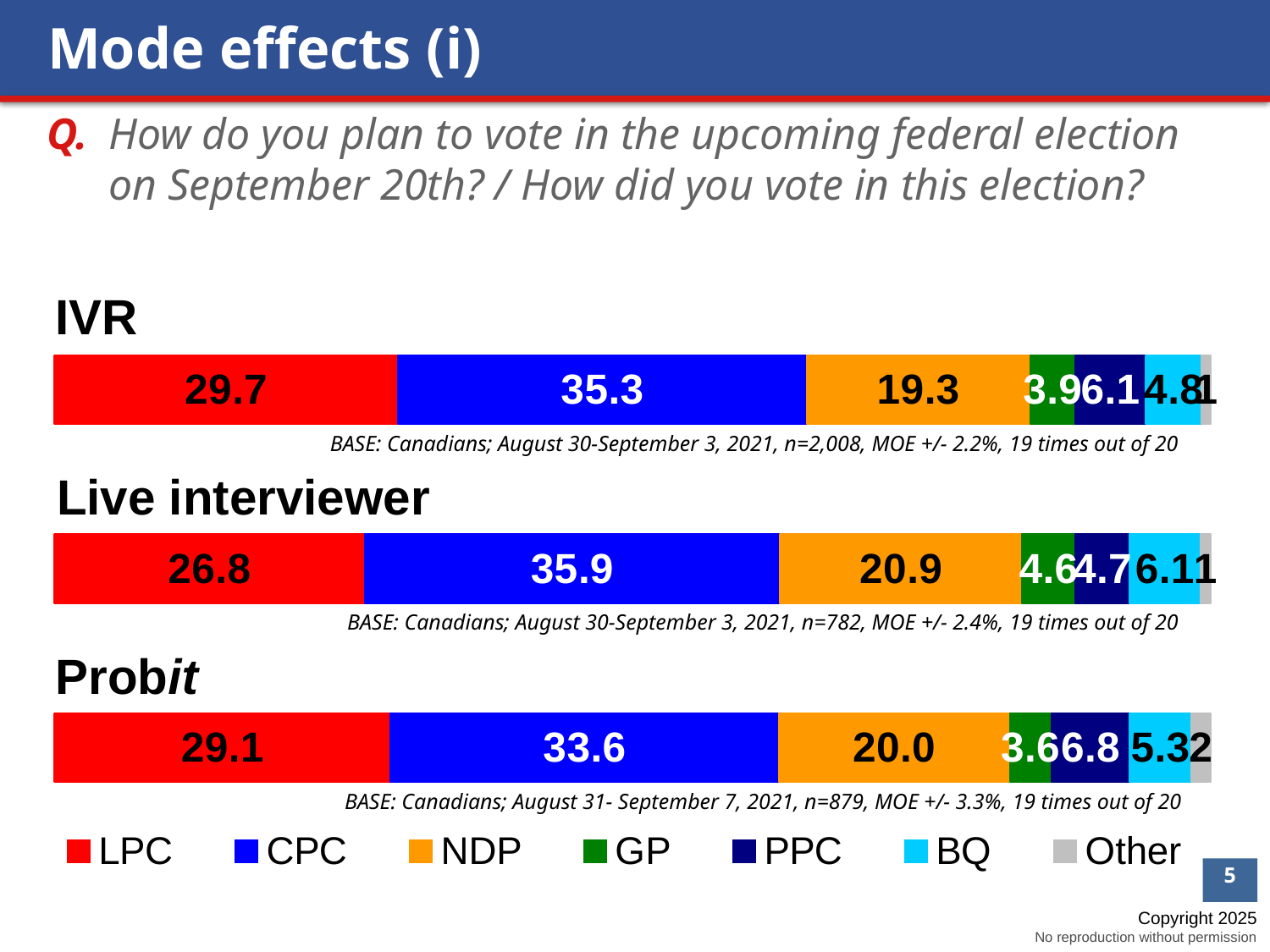
How many bar charts are shown on the slide? 3 What kind of chart is used for the IVR results? Stacked bar chart In the Live interviewer chart, what is the value for NDP? 20.9 In the IVR chart, what is the value for CPC? 35.3 In the Probit chart, which is larger, LPC or CPC? CPC In the Live interviewer chart, what is the difference between the CPC and NDP values? 15.0 How many parties does the legend list? 7 In the IVR chart, which party has the largest share? CPC In the Probit chart, what is the value for NDP? 20.0 In the Live interviewer chart, what is the value for LPC? 26.8 What colour represents NDP in the legend? Orange Is the LPC value larger in the IVR chart or in the Probit chart? IVR